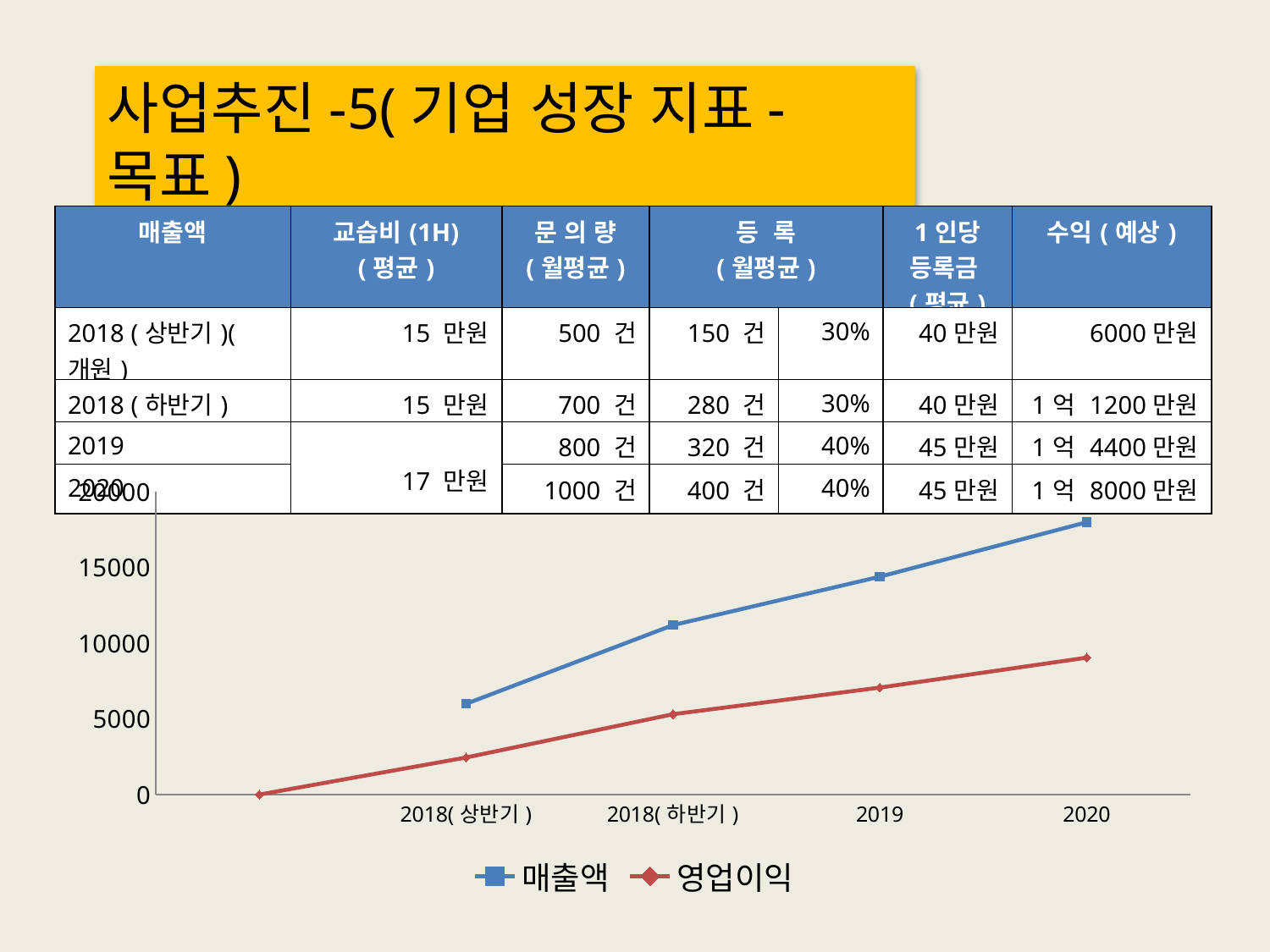
What kind of chart is shown on the slide? line chart What are the two series named in the chart legend? 매출액 and 영업이익 Is the 매출액 value for 2018(하반기) greater or less than 10000? greater Does the 매출액 series rise or fall from 2018(상반기) to 2020? rise Which series is drawn in blue with square markers? 매출액 How many category labels are shown on the x axis of the chart? 4 At which x-axis category is 매출액 highest? 2020 Does the 영업이익 series rise or fall along the x axis? rise Which is larger in 2020, 매출액 or 영업이익? 매출액 Is the 매출액 value for 2020 greater or less than 15000? greater How many series does the chart legend list? 2 Is the 영업이익 value for 2020 greater or less than 10000? less